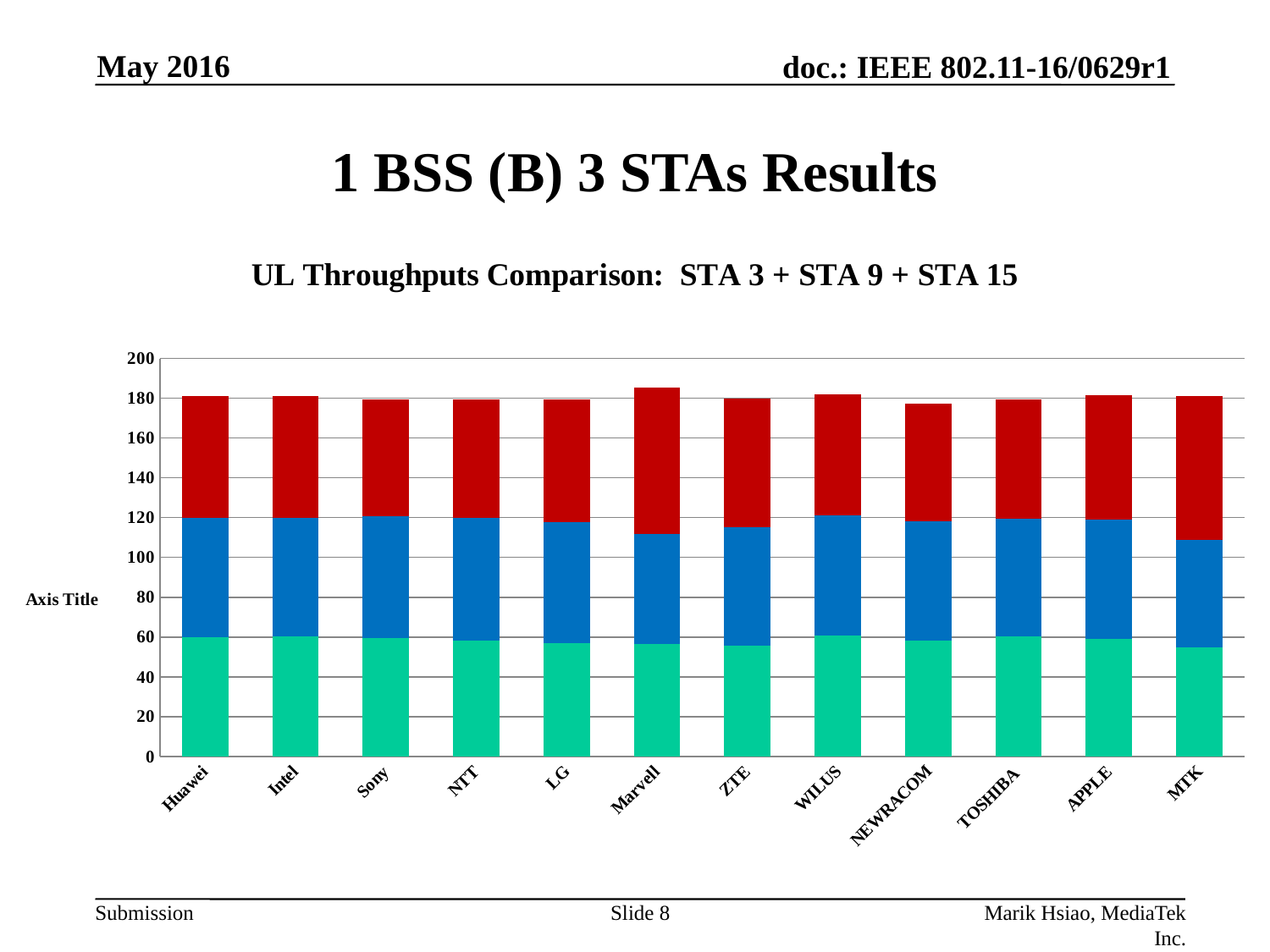
Which has the taller total stacked bar, Marvell or NEWRACOM? Marvell How many stacked segments make up each bar in the chart? 3 What colour is the bottom segment of each stacked bar? green What kind of chart is shown on the slide? stacked bar chart What is the title shown above the chart? UL Throughputs Comparison: STA 3 + STA 9 + STA 15 Does the top of the blue segment for MTK sit above or below the 120 gridline? below How many categories (companies) are shown along the x axis of the chart? 12 Is the total stacked bar for NEWRACOM greater or less than 180? less Which company has the tallest stacked bar in the chart? Marvell Is the green (bottom) segment for Intel greater or less than 40? greater